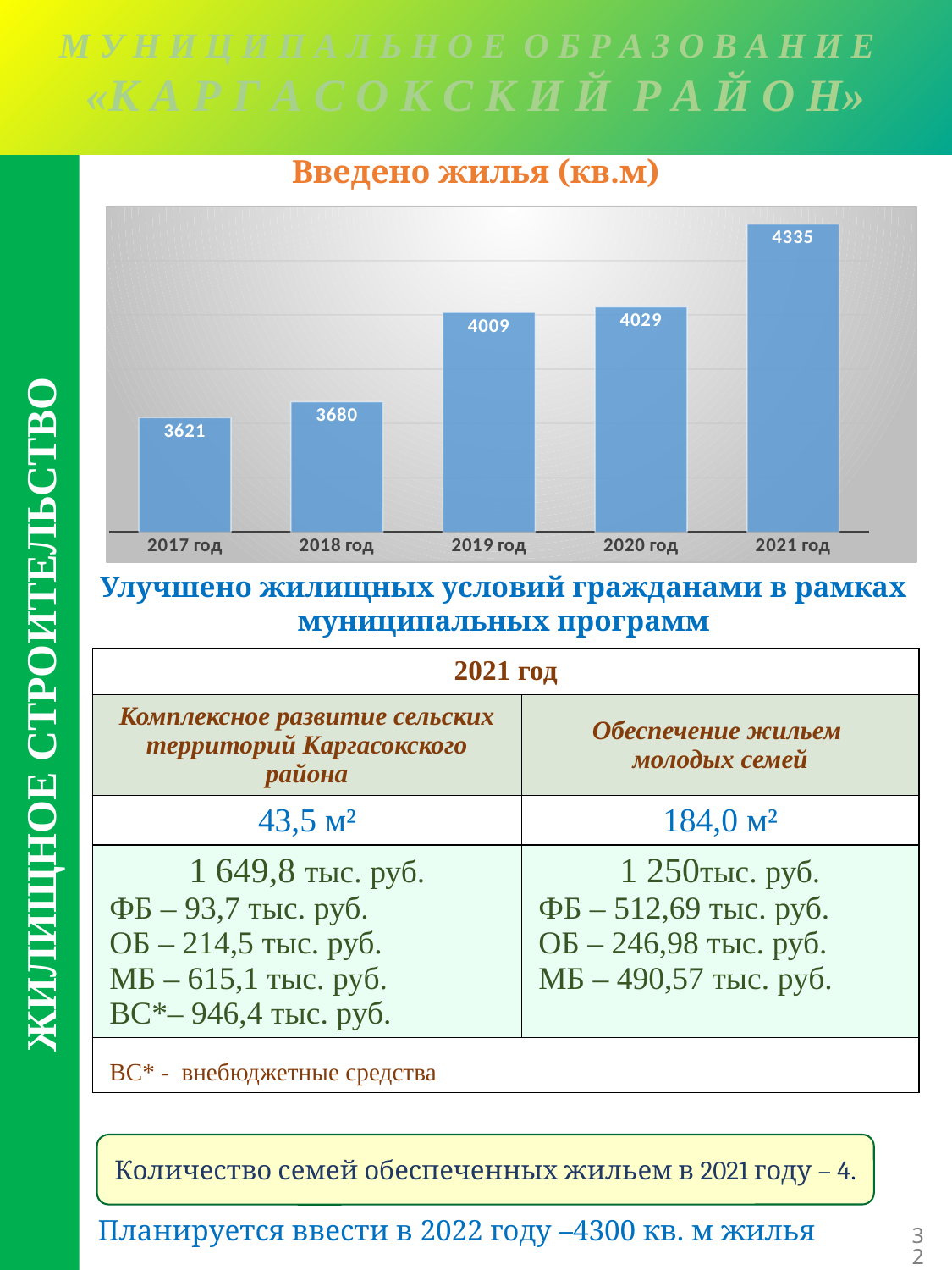
Do the values in the chart 'Введено жилья (кв.м)' rise or fall from 2017 год to 2021 год? rise What is the value for 2019 год in the chart 'Введено жилья (кв.м)'? 4009 How many years are shown in the chart 'Введено жилья (кв.м)'? 5 What is the difference between the values for 2018 год and 2017 год in the chart 'Введено жилья (кв.м)'? 59 What is the title of the bar chart on the slide? Введено жилья (кв.м) What is the value for 2017 год in the chart 'Введено жилья (кв.м)'? 3621 What kind of chart is 'Введено жилья (кв.м)'? bar chart Which is larger in the chart 'Введено жилья (кв.м)': the value for 2019 год or 2018 год? 2019 год Which year has the lowest value in the chart 'Введено жилья (кв.м)'? 2017 год What is the difference between the values for 2021 год and 2017 год in the chart 'Введено жилья (кв.м)'? 714 Which year has the highest value in the chart 'Введено жилья (кв.м)'? 2021 год What is the value for 2021 год in the chart 'Введено жилья (кв.м)'? 4335